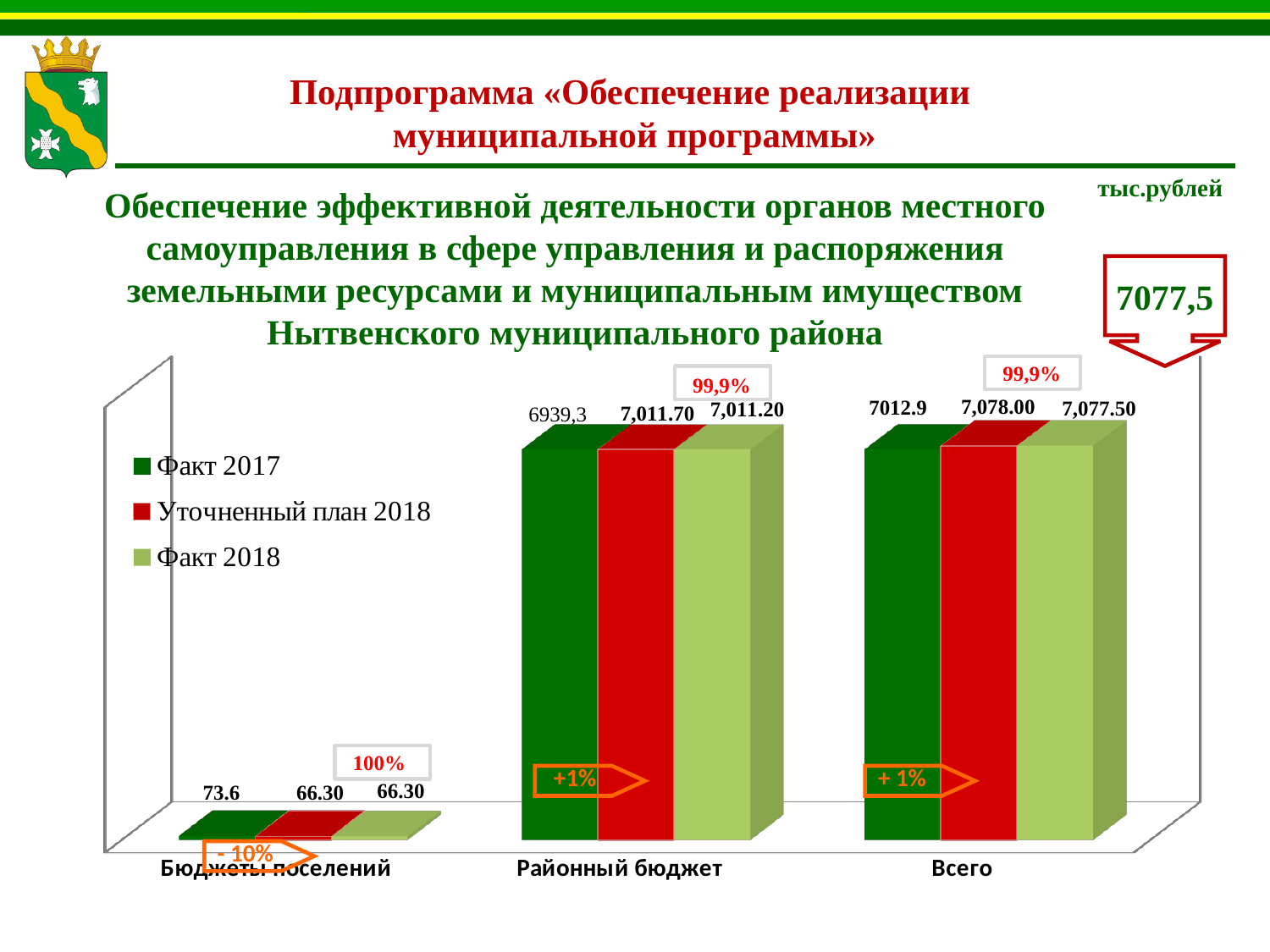
Which is larger for Бюджеты поселений: Факт 2017 or Факт 2018? Факт 2017 What kind of chart is shown on the slide? bar chart Which category has the lowest Факт 2018 value? Бюджеты поселений How many series does the chart legend list? 3 What is the difference between Уточненный план 2018 and Факт 2018 for Всего? 0.50 Which series is shown in red in the chart legend? Уточненный план 2018 What is the value of Факт 2018 for Всего? 7,077.50 What is the value of Факт 2017 for Всего? 7012.9 What is the value of Уточненный план 2018 for Районный бюджет? 7,011.70 How many categories are shown on the x axis of the chart? 3 Which category has the highest Уточненный план 2018 value? Всего What is the value of Факт 2017 for Бюджеты поселений? 73.6